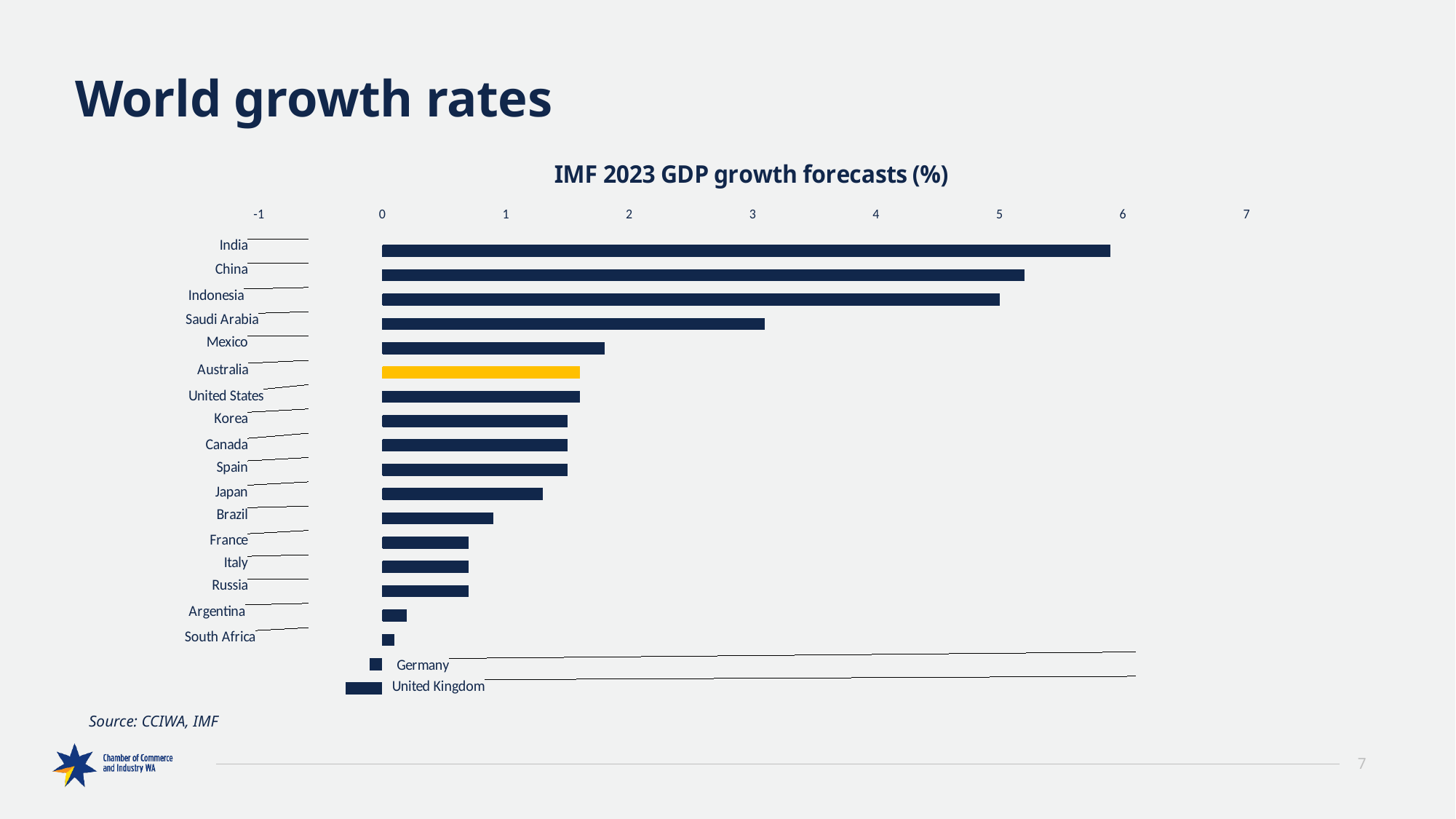
How many countries are shown in the chart? 19 Which country has the lowest 2023 GDP growth forecast in the chart? United Kingdom Is the value for Mexico greater or less than 2? less Which has the larger growth forecast, Mexico or Australia? Mexico Which country has the highest 2023 GDP growth forecast in the chart? India What kind of chart is shown on the slide? Bar chart Which country's bar is highlighted in a different colour (yellow) from the others? Australia Is the value for Australia greater or less than 1? greater What is the title of the chart? IMF 2023 GDP growth forecasts (%) Is the value for India greater or less than 5? greater Which has the larger growth forecast, Japan or Brazil? Japan